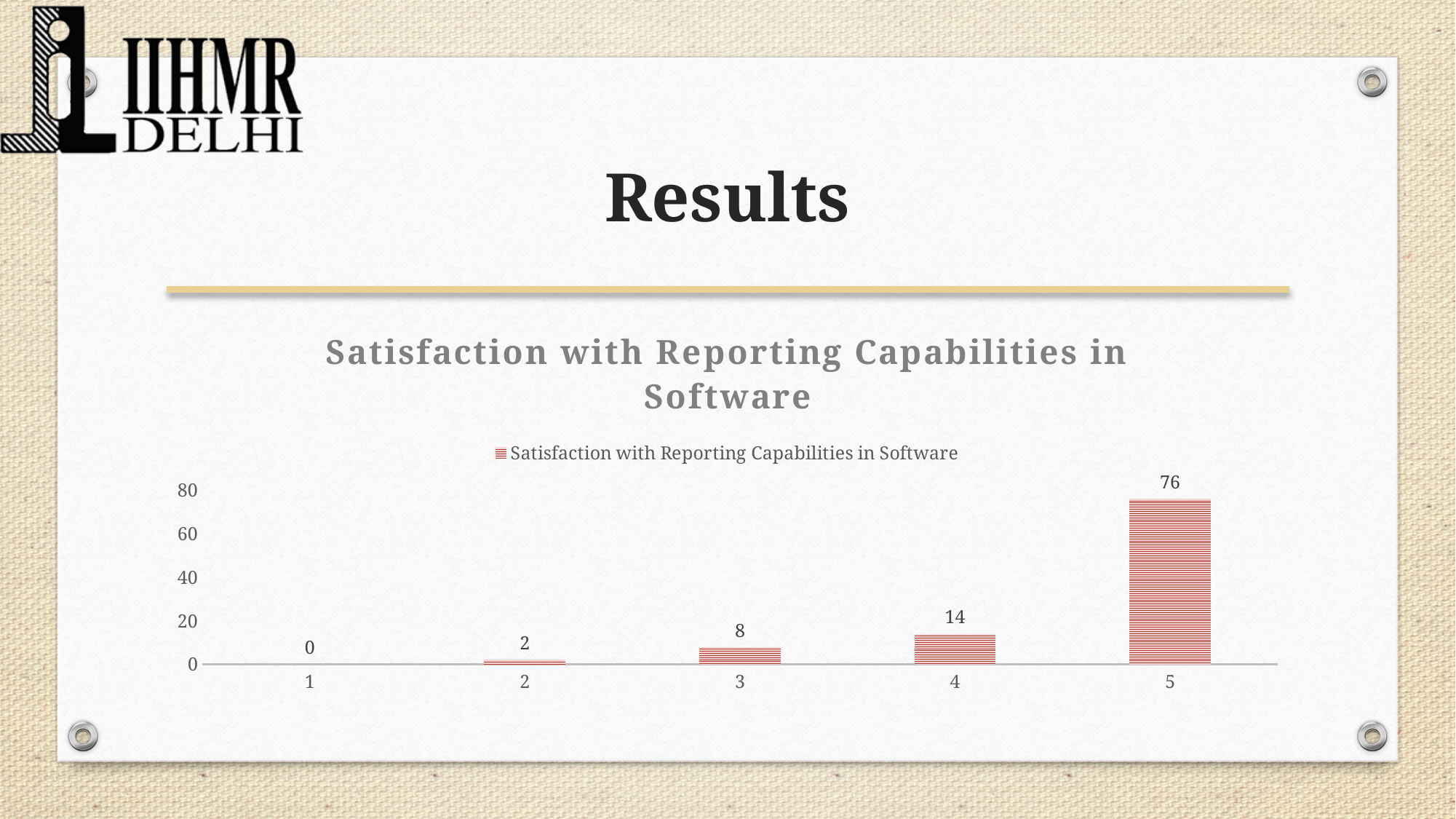
Is the value for category 5 greater or less than 60? greater What is the value for category 3? 8 What is the difference between the values for category 5 and category 4? 62 Do the values rise or fall from category 1 to category 5? rise Which category has the highest value? 5 What kind of chart is shown on the slide? bar chart Which category has the lowest value? 1 How many categories are shown on the x axis? 5 What is the value for category 4? 14 What is the value for category 1? 0 Which is larger, the value for category 2 or the value for category 3? 3 What is the value for category 5 in the Satisfaction with Reporting Capabilities in Software chart? 76